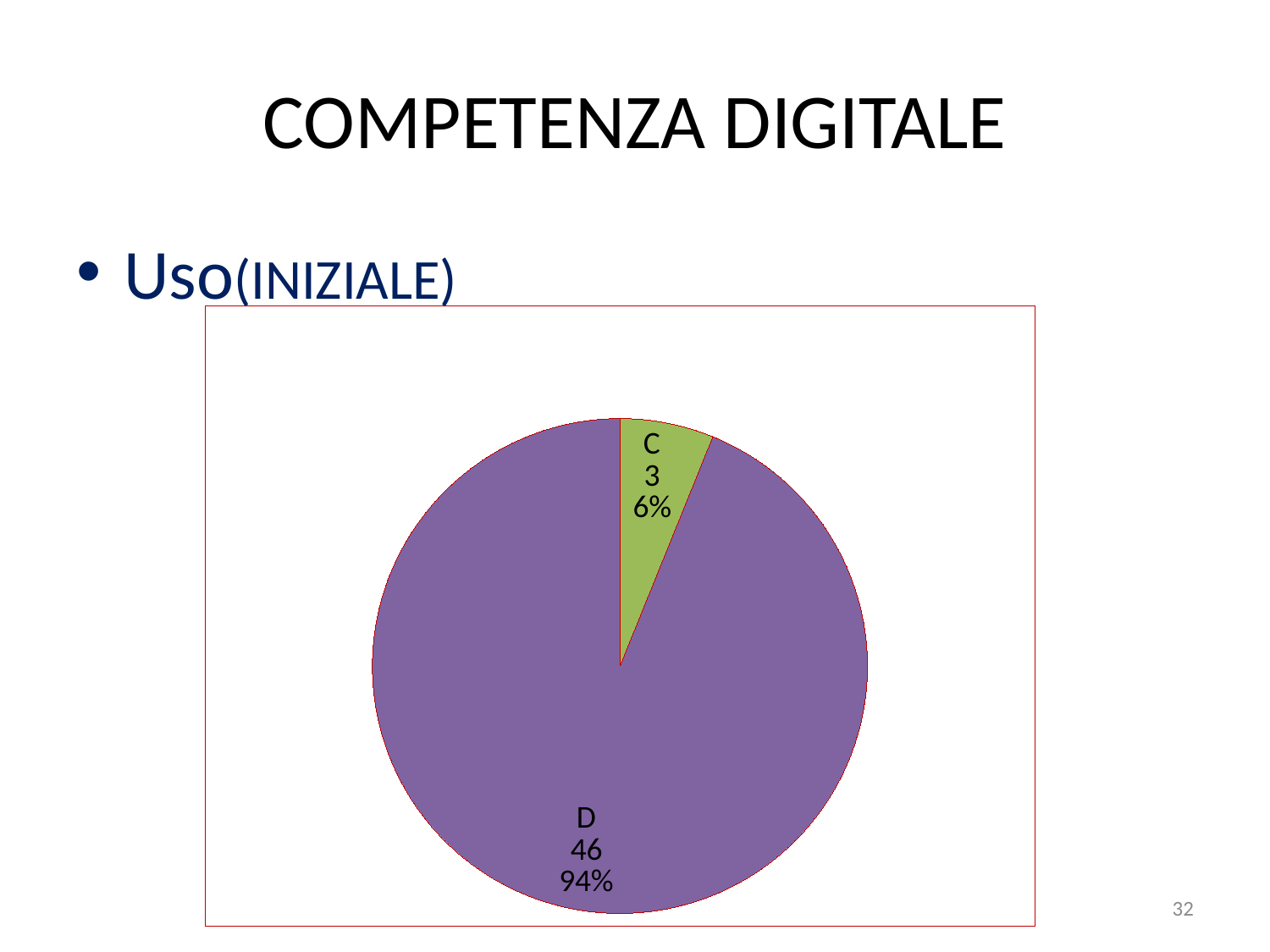
What percentage share of the pie does slice C have? 6% Which category has the largest slice? D What is the value for category C? 3 What is the value for category D? 46 Which category has the smallest slice? C What is the total of the values shown in the pie chart? 49 What percentage share of the pie does slice D have? 94% What is the difference between the values for D and C? 43 What colour is the slice for category C? green What kind of chart is shown on the slide? pie chart Which is larger, the value for C or the value for D? D How many slices does the pie chart have? 2